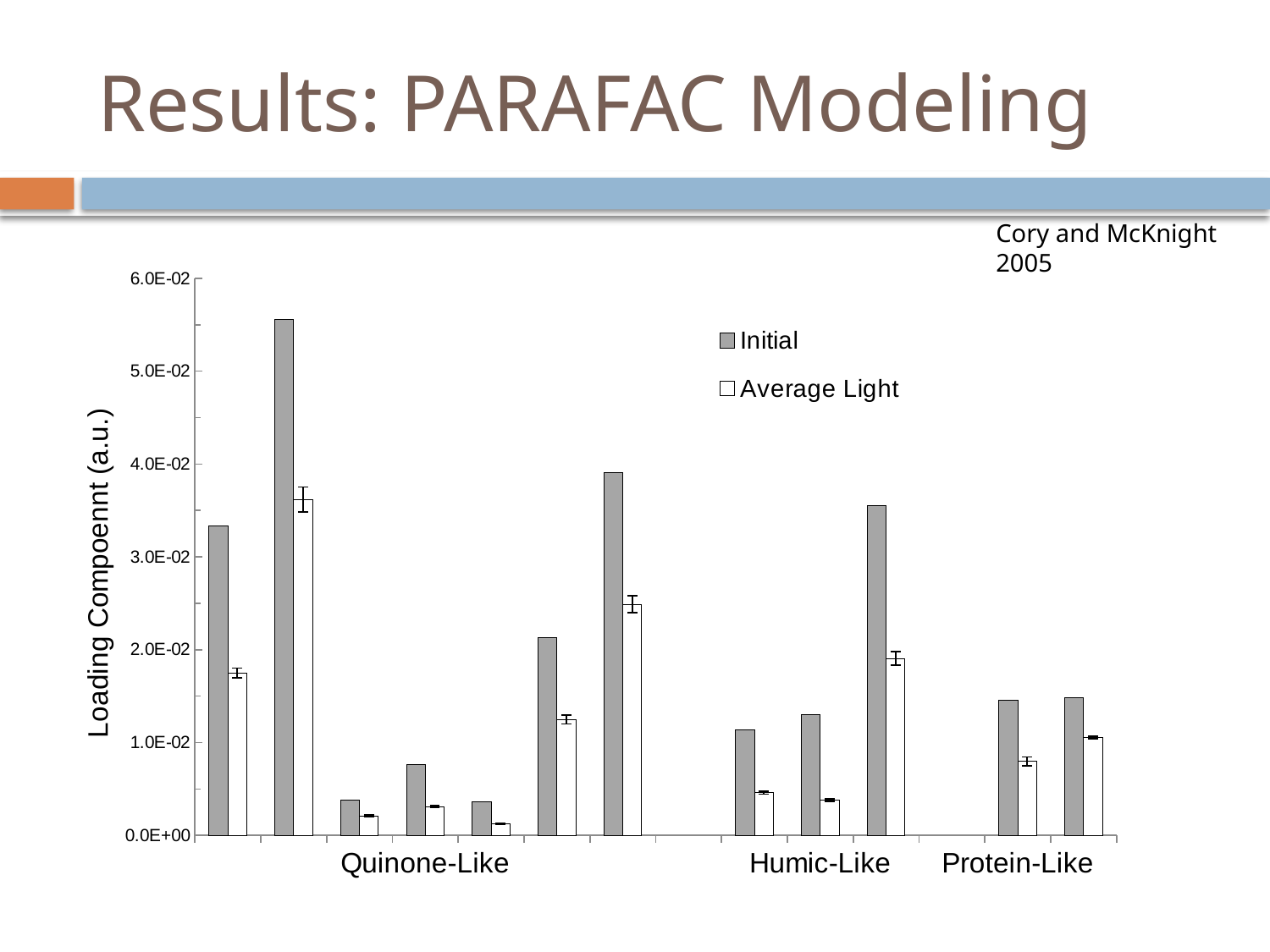
How many labelled component groups are shown along the x axis? 3 Is the tallest Average Light bar in the Quinone-Like group greater or less than 3.0E-02? greater Which labelled group contains the tallest bar on the chart? Quinone-Like Within each pair of bars, which series is consistently larger, Initial or Average Light? Initial Is the tallest Initial bar in the Quinone-Like group greater or less than 5.0E-02? greater Is the tallest Initial bar in the Humic-Like group greater or less than 3.0E-02? greater What are the two series named in the legend? Initial and Average Light What kind of chart is shown on the slide? bar chart What is the label on the y axis? Loading Compoennt (a.u.) How many series does the legend list? 2 Which series does the tallest bar on the chart belong to? Initial How many pairs of Initial/Average Light bars are plotted in total? 12